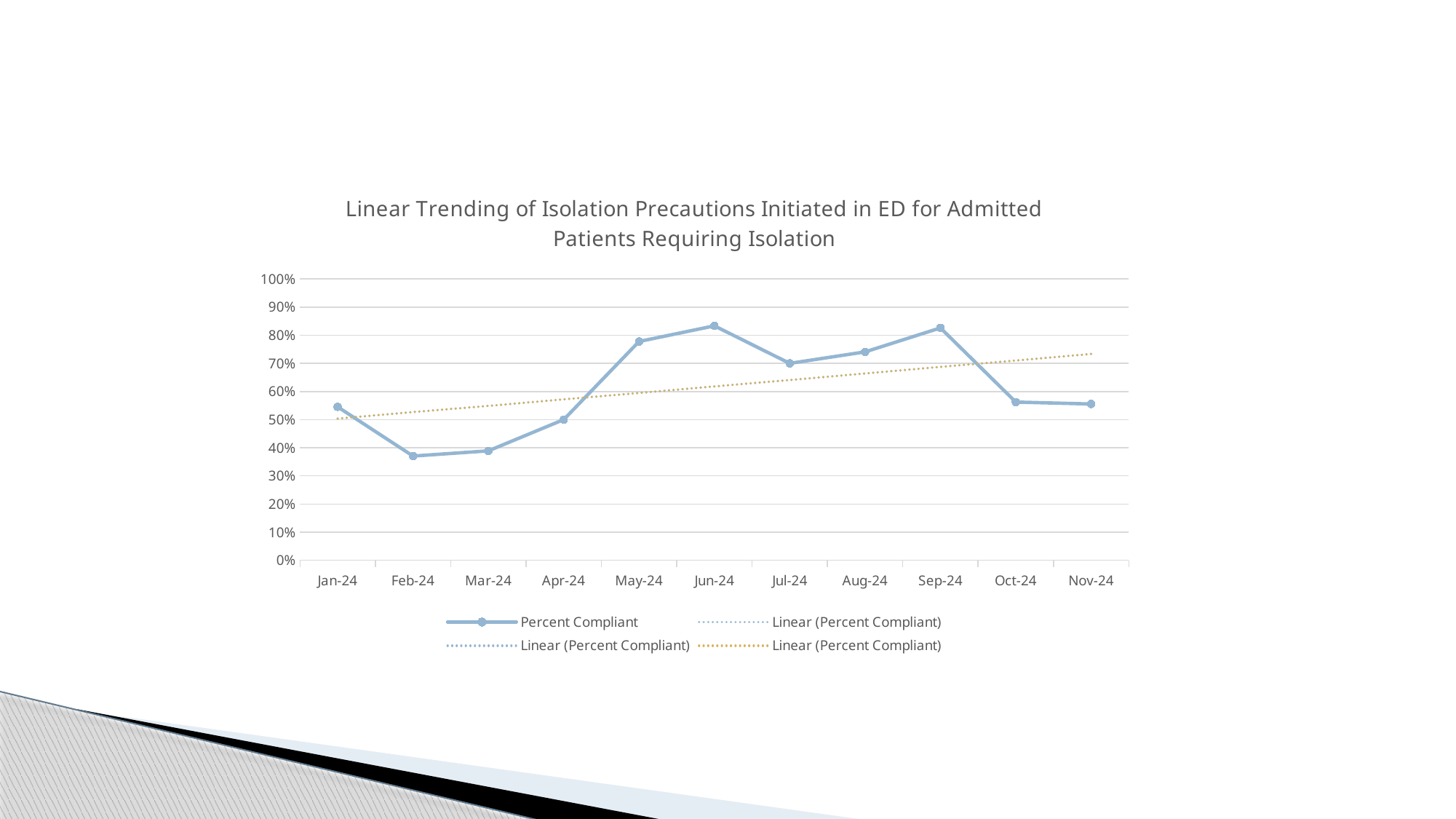
Is the Percent Compliant value for Sep-24 greater or less than 70%? greater Is the Percent Compliant value for May-24 greater or less than 70%? greater Is the Percent Compliant value for Oct-24 greater or less than 50%? greater What is the title of the chart? Linear Trending of Isolation Precautions Initiated in ED for Admitted Patients Requiring Isolation How many months are plotted along the x axis? 11 How many entries does the legend list? 4 Does the dotted linear trendline rise or fall from Jan-24 to Nov-24? Rise Which month has the higher Percent Compliant value, Jun-24 or Oct-24? Jun-24 What is the name of the plotted data series in the legend? Percent Compliant What kind of chart is shown on the slide? Line chart Which month has the higher Percent Compliant value, Feb-24 or May-24? May-24